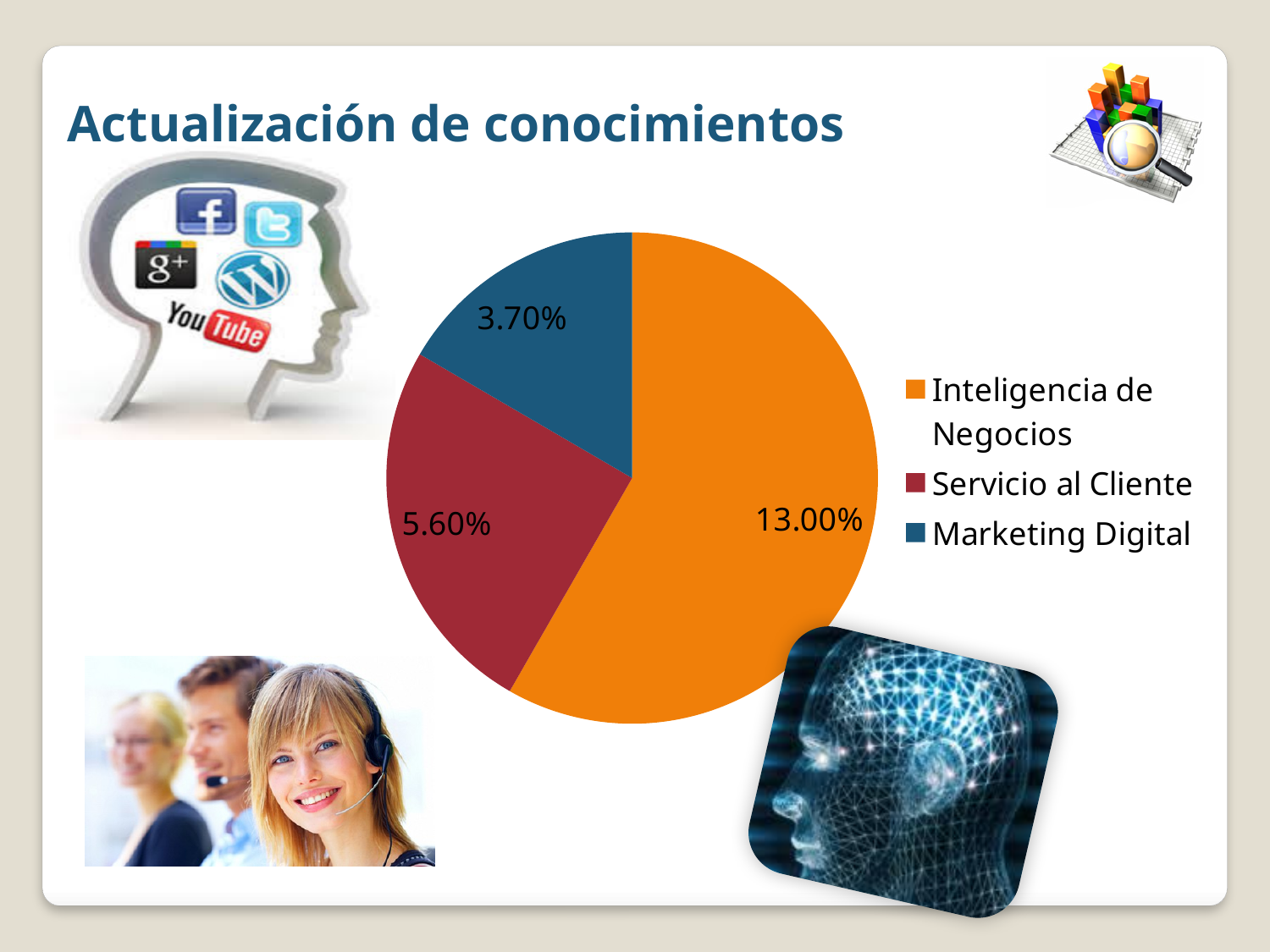
Which category has the smallest slice of the pie? Marketing Digital How many categories does the pie chart have? 3 What is the difference between the values for Servicio al Cliente and Marketing Digital? 1.90% Which category has the largest slice of the pie? Inteligencia de Negocios What value is shown for Servicio al Cliente? 5.60% What is the difference between the values for Inteligencia de Negocios and Servicio al Cliente? 7.40% What kind of chart is shown on the slide? Pie chart What value is shown for Marketing Digital? 3.70% What is the title of the slide containing the pie chart? Actualización de conocimientos What colour is the slice for Inteligencia de Negocios? Orange Which is larger, the value for Servicio al Cliente or the value for Marketing Digital? Servicio al Cliente What value is shown for Inteligencia de Negocios? 13.00%